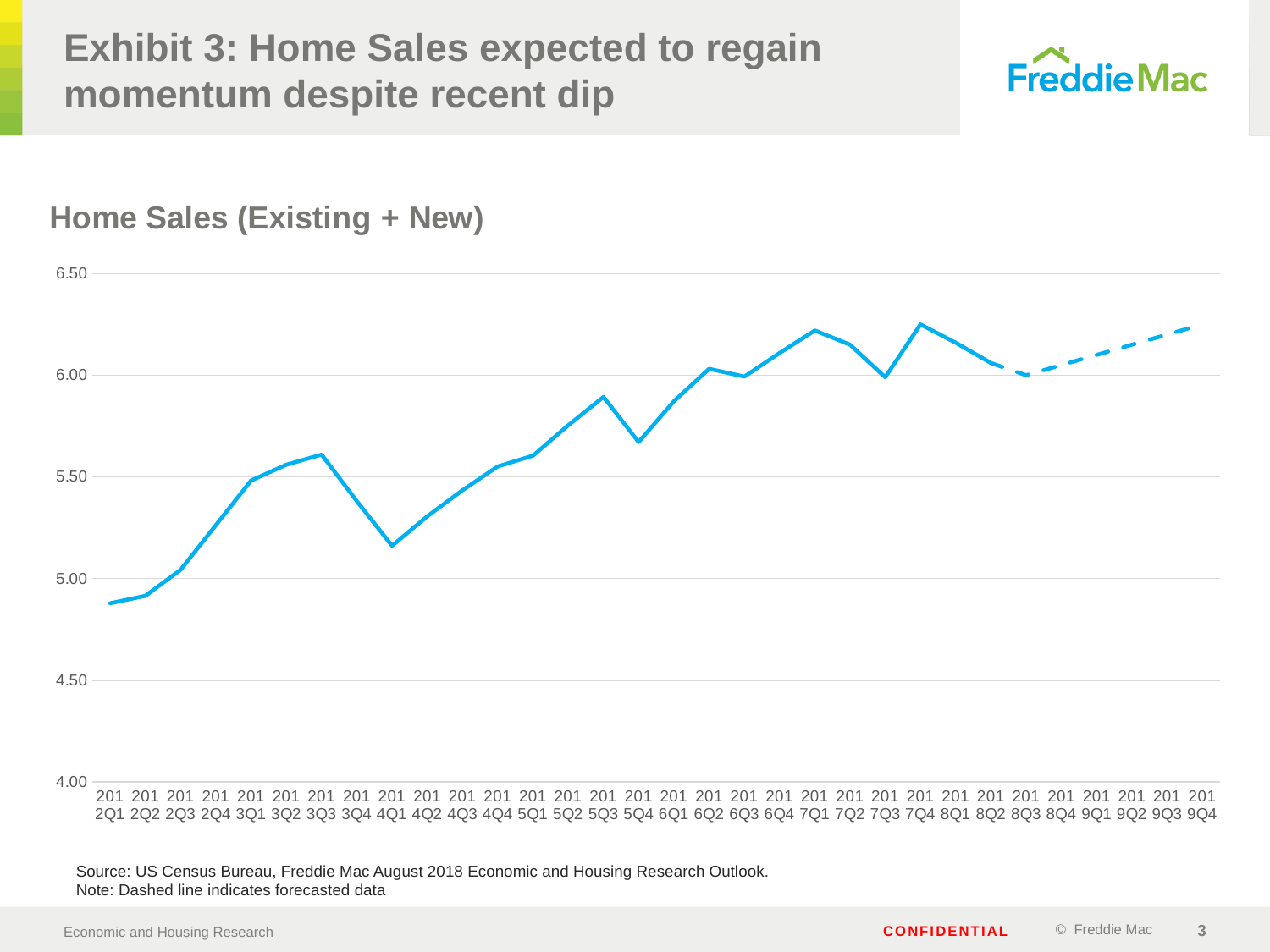
Is the value for 2015Q4 greater or less than 5.50? greater Which is larger, the value for 2013Q3 or the value for 2014Q1? 2013Q3 Is the value for 2019Q4 greater or less than 6.00? greater Is the value for 2014Q1 greater or less than 5.50? less How many quarterly points are plotted on the x axis? 32 Which quarter has the lowest home sales value? 2012Q1 Overall, do home sales rise or fall from 2012Q1 to 2019Q4? rise What kind of chart is shown on the slide? line chart According to the note, what does the dashed portion of the line indicate? forecasted data What is the title of the chart? Home Sales (Existing + New)